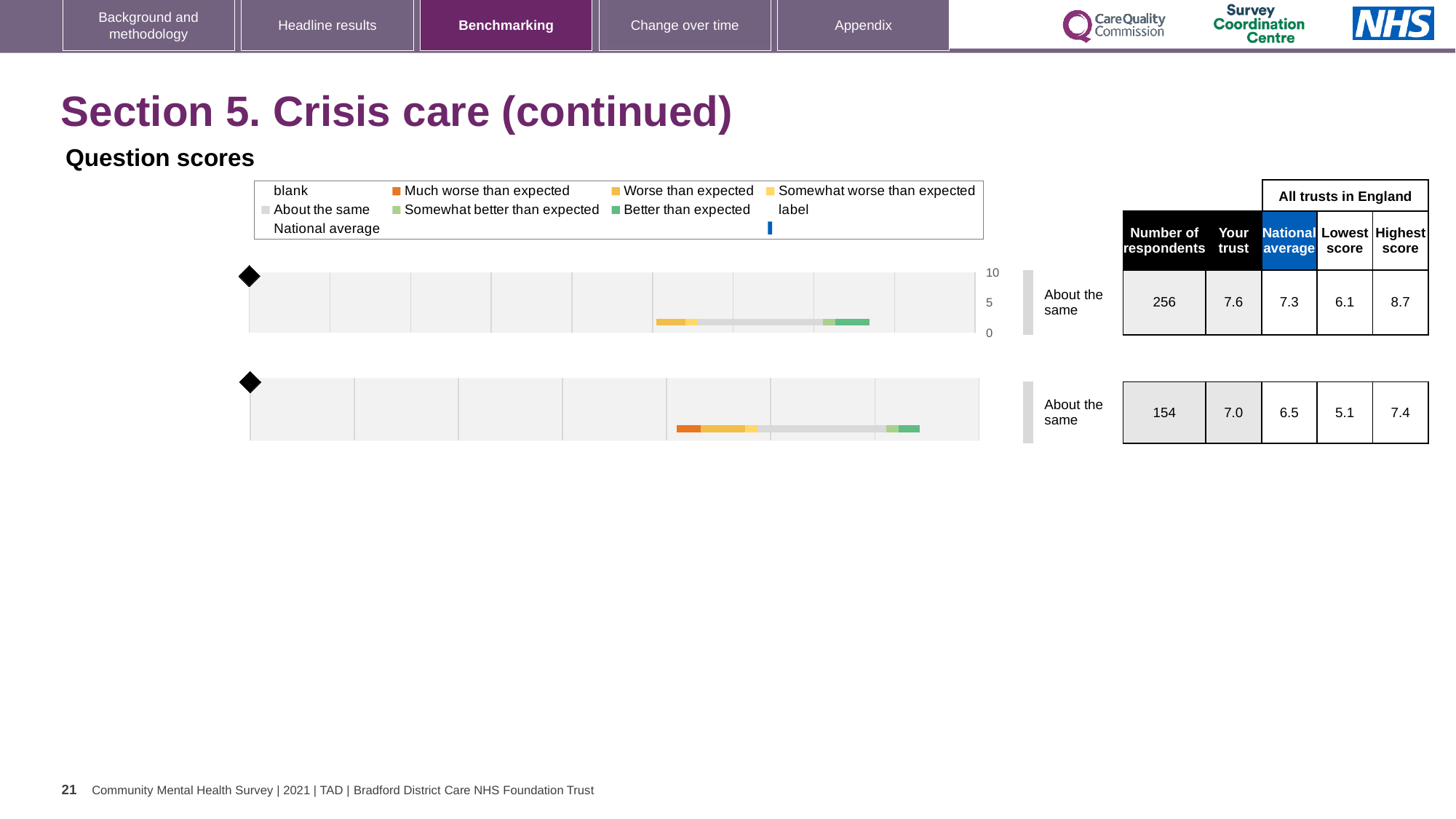
What benchmark category label is shown next to the bottom chart? About the same In the top chart, what is the score for Your trust? 7.6 In the bottom chart, what is the score for Your trust? 7.0 In the legend, what colour represents 'Much worse than expected'? Orange In the top chart, what is the difference between the Highest score and the Lowest score? 2.6 What kind of chart is used to show the question scores on this slide? Bar chart In the bottom chart, what is the Highest score among all trusts in England? 7.4 In the bottom chart, what is the Lowest score among all trusts in England? 5.1 In the top chart, what is the difference between Your trust score and the National average? 0.3 In the bottom chart, which is larger: Your trust score or the National average? Your trust In the top chart, what is the National average score? 7.3 In the top chart, how many respondents are shown? 256